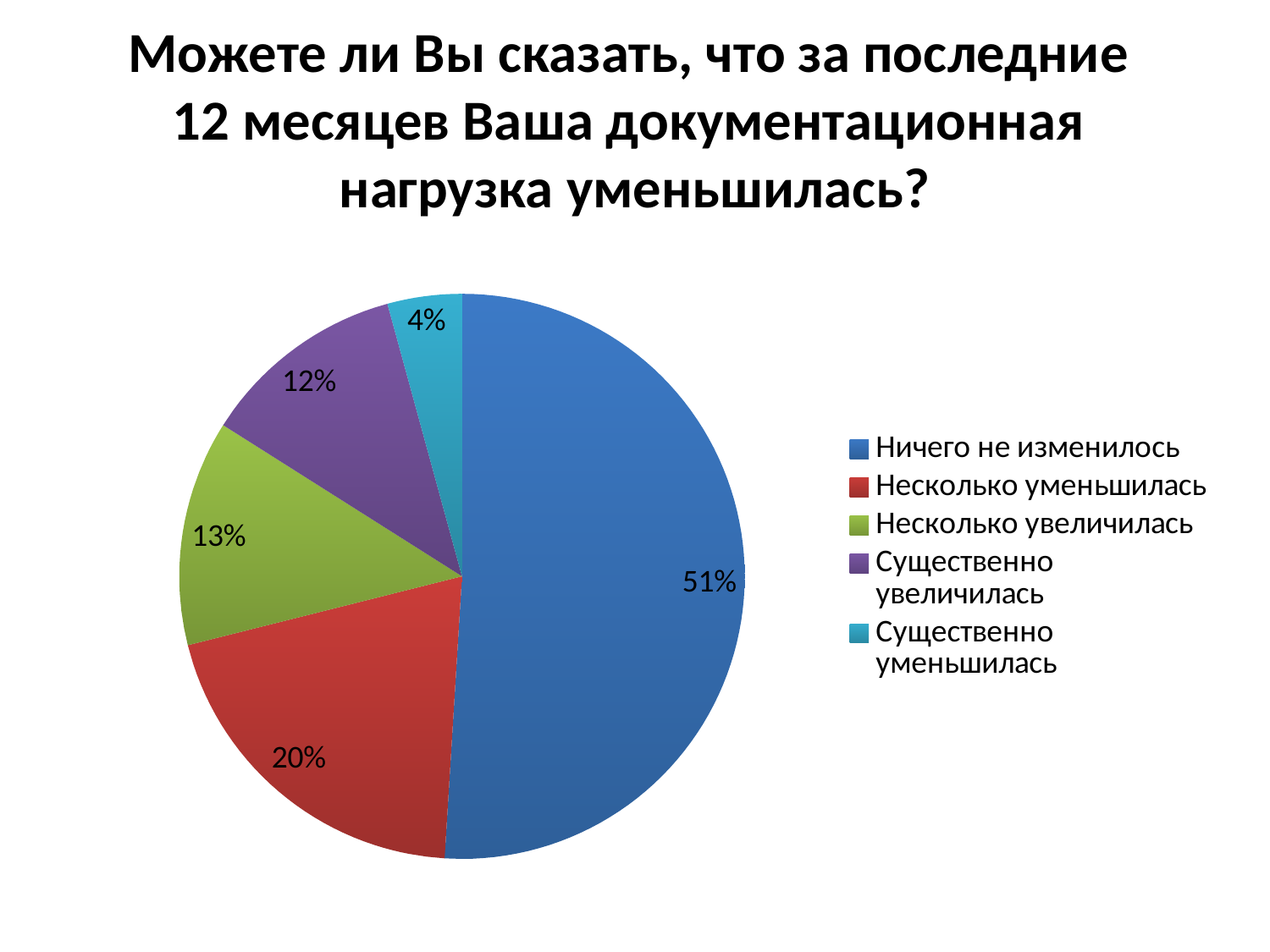
What kind of chart is shown on the slide? pie chart What is the difference in percentage points between "Ничего не изменилось" and "Несколько уменьшилась"? 31 What share of the pie is labelled "Несколько уменьшилась"? 20% What share of the pie is labelled "Ничего не изменилось"? 51% What share of the pie is labelled "Несколько увеличилась"? 13% What share of the pie is labelled "Существенно уменьшилась"? 4% Which is larger: the slice for "Несколько уменьшилась" or the slice for "Существенно увеличилась"? Несколько уменьшилась What share of the pie is labelled "Существенно увеличилась"? 12% What colour is the slice for "Несколько увеличилась"? green Which category has the largest slice of the pie? Ничего не изменилось Which category has the smallest slice of the pie? Существенно уменьшилась How many categories does the legend list? 5